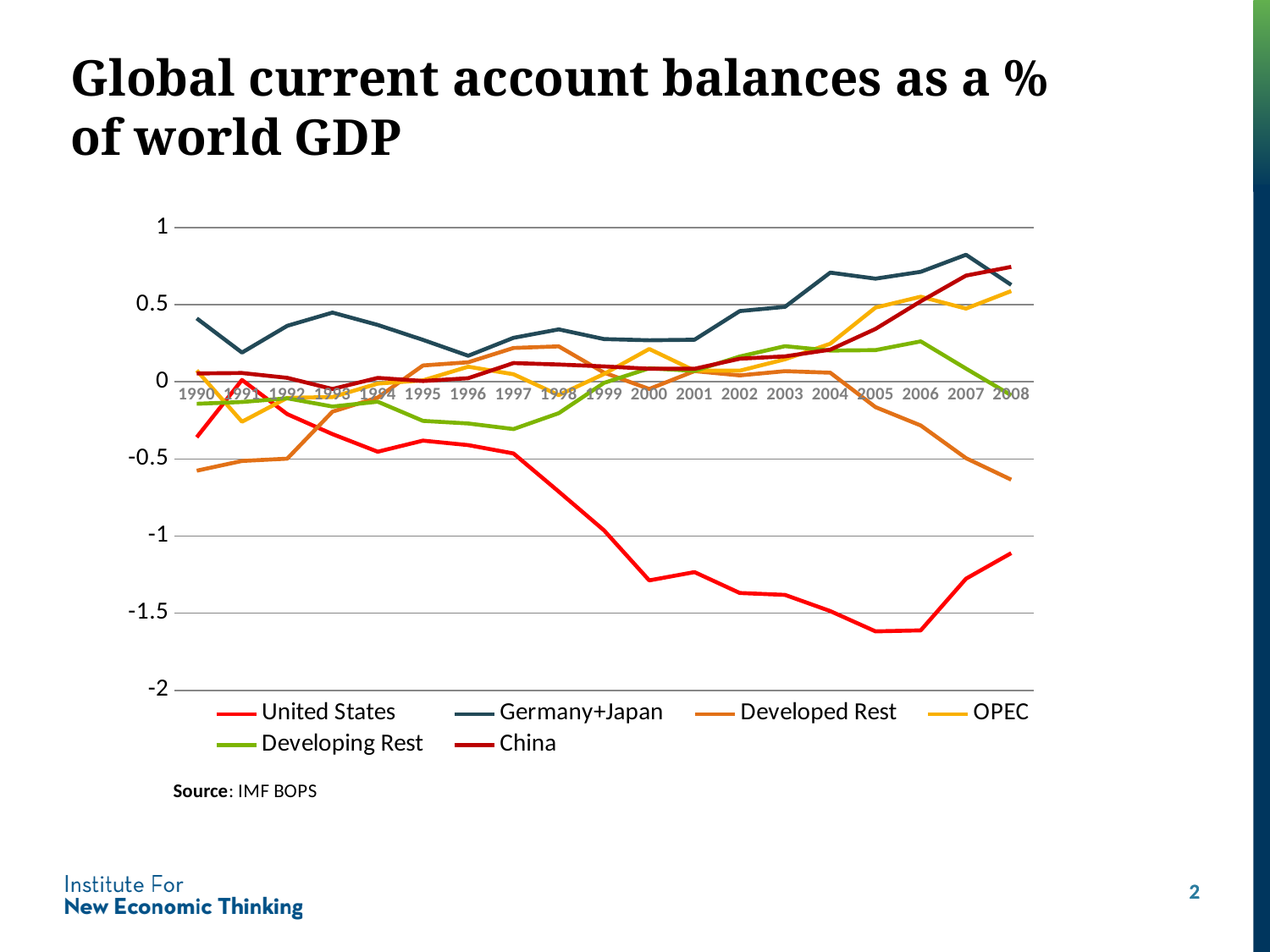
Is the value for Germany+Japan in 2007 greater or less than 0.5? greater Which series has the highest value in 2007? Germany+Japan Does the United States series generally rise or fall from 1990 to 2006? fall How many series does the legend list? 6 Is the value for United States in 2006 greater or less than -1.5? less In 2008, which is larger: the value for China or the value for Developed Rest? China Is the value for Developed Rest in 2008 greater or less than -0.5? less How many years are plotted along the x axis? 19 Which series has the lowest value in 2006? United States What is the source cited below the chart? IMF BOPS What kind of chart is shown on the slide? line chart